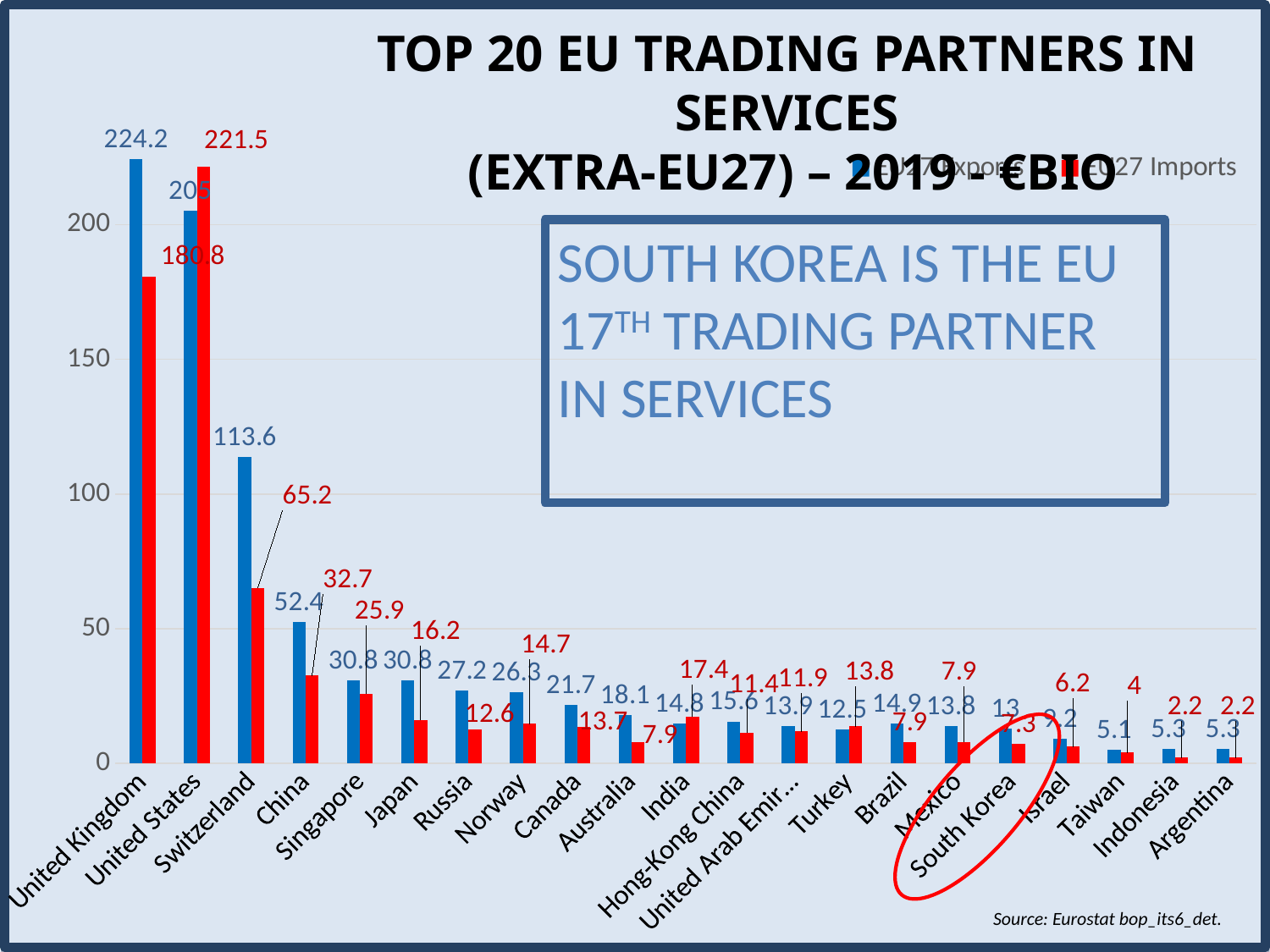
What is the difference between EU27 Exports and EU27 Imports for the United Kingdom? 43.4 What kind of chart is shown on the slide? bar chart For the United States, which is larger: EU27 Exports or EU27 Imports? EU27 Imports Which trading partner has the highest EU27 Exports value? United Kingdom How many series does the legend list? 2 What colour are the EU27 Imports bars? red Which trading partner has the highest EU27 Imports value? United States What is the EU27 Exports value for South Korea? 13 What is the EU27 Imports value for Switzerland? 65.2 What is the EU27 Exports value for China? 52.4 Is the EU27 Exports value for Switzerland greater or less than 100? greater What is the EU27 Exports value for the United Kingdom? 224.2